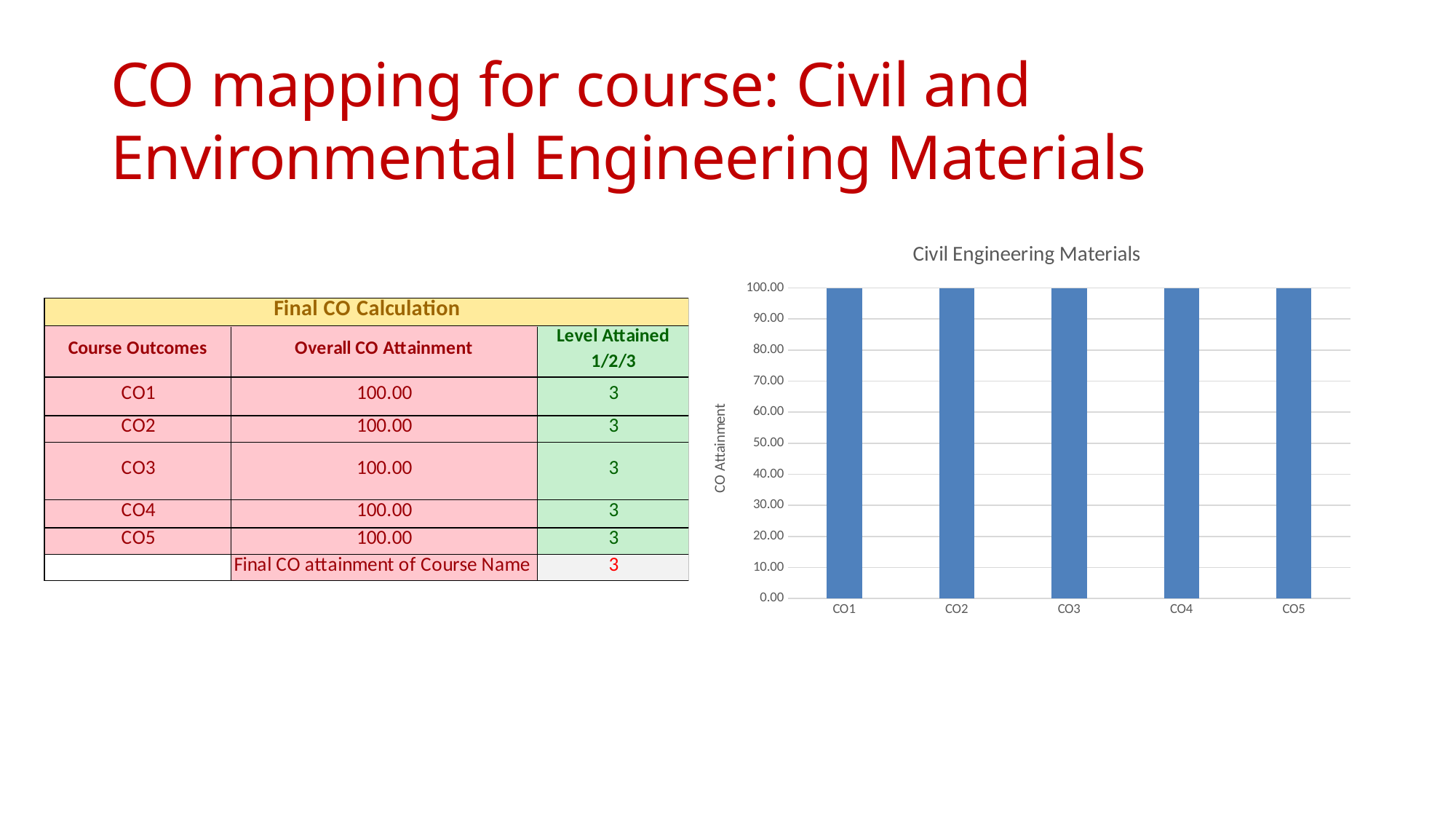
What is the difference between the values for CO1 and CO2? 0.00 Is the value for CO2 greater or less than 50.00? greater What is the value for CO5 in the chart? 100.00 What kind of chart is shown on the slide? bar chart What is the label on the vertical axis of the chart? CO Attainment How many categories are plotted on the x axis of the chart? 5 What is the title of the chart? Civil Engineering Materials What is the value for CO1 in the chart? 100.00 Is the value for CO4 greater or less than 90.00? greater Do the values rise, fall, or stay the same from CO1 to CO5? stay the same What is the value for CO3 in the chart? 100.00